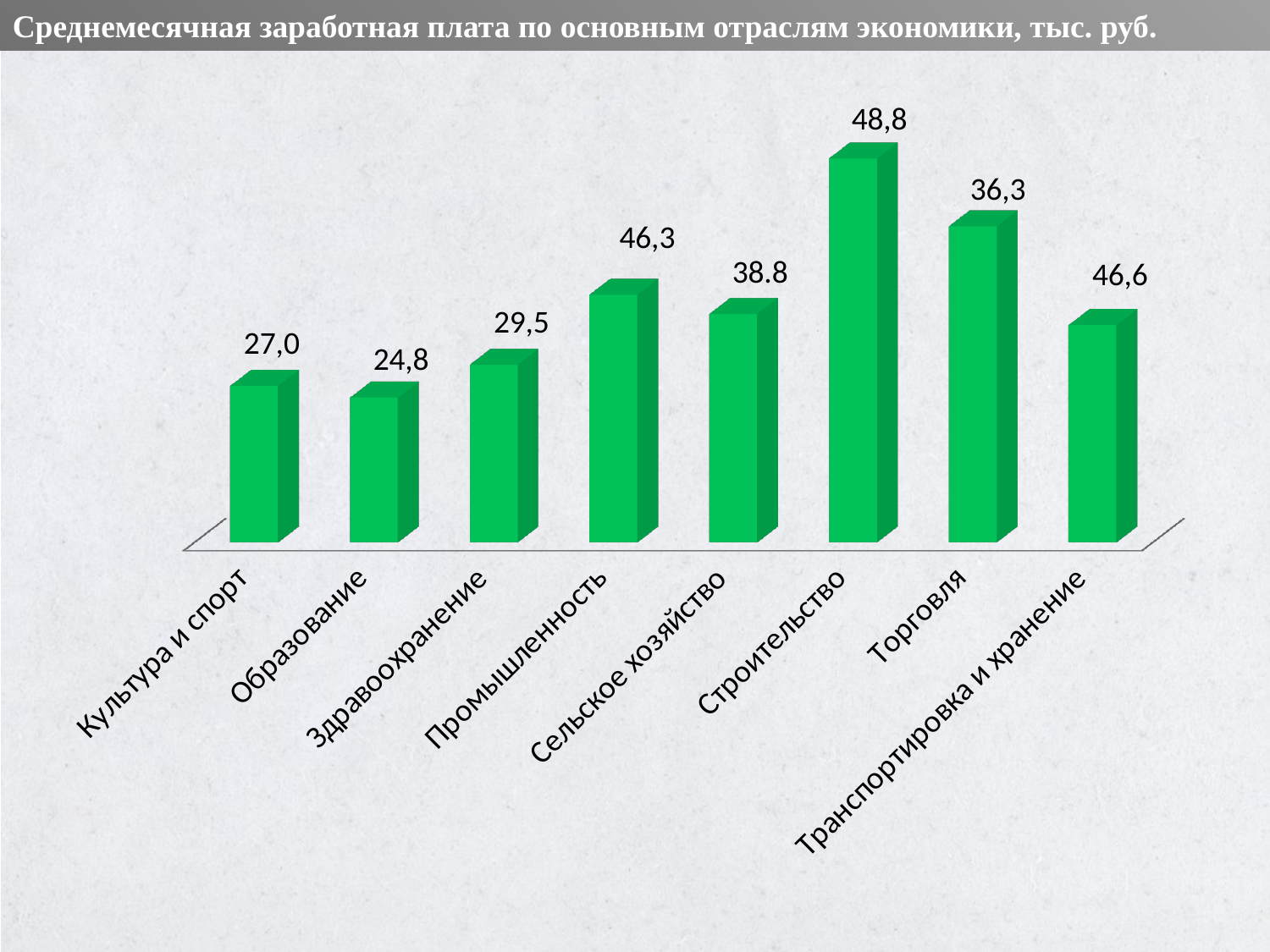
What kind of chart is shown on the slide? Bar chart What is the value for Сельское хозяйство? 38.8 Which category has the highest value? Строительство What is the value for Образование? 24,8 Which category has the lowest value? Образование What is the value for Транспортировка и хранение? 46,6 How many categories are shown in the chart? 8 What is the difference between the values for Строительство and Образование? 24,0 What is the title of the chart? Среднемесячная заработная плата по основным отраслям экономики, тыс. руб. What is the value for Строительство? 48,8 What is the difference between the values for Здравоохранение and Культура и спорт? 2,5